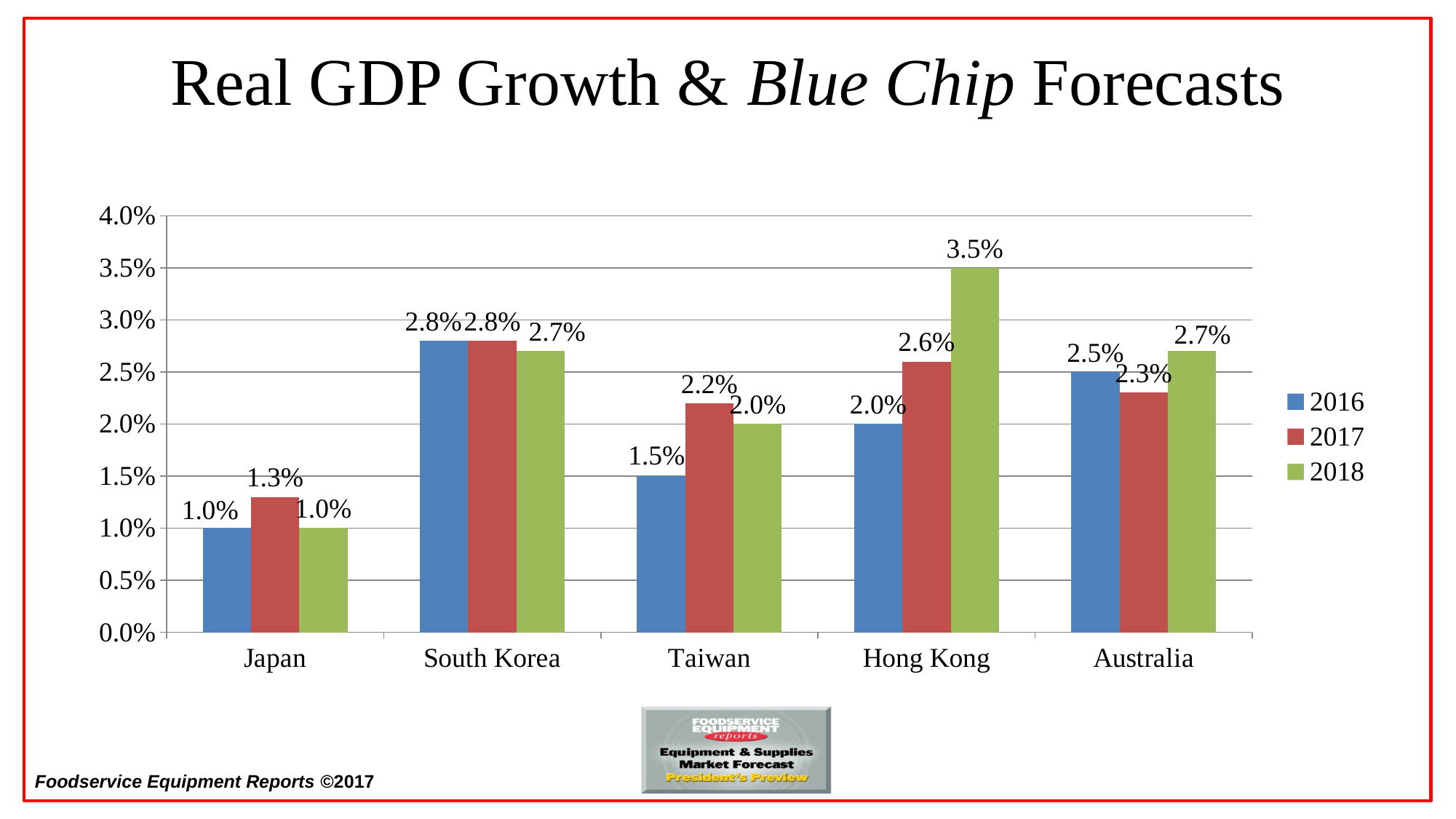
Which is larger, the 2017 value for Taiwan or the 2017 value for Australia? Australia What is the 2018 value for Hong Kong? 3.5% What is the difference between the 2018 and 2016 values for Hong Kong? 1.5% How many countries are shown on the x axis? 5 Which country has the highest 2018 value? Hong Kong Do the values for Taiwan rise or fall from 2016 to 2018? Rise What is the 2016 value for Taiwan? 1.5% How many series does the legend list? 3 What is the 2017 value for Australia? 2.3% What kind of chart is shown on the slide? Bar chart Which country has the lowest 2016 value? Japan Is the 2016 value for South Korea greater or less than 2.5%? greater